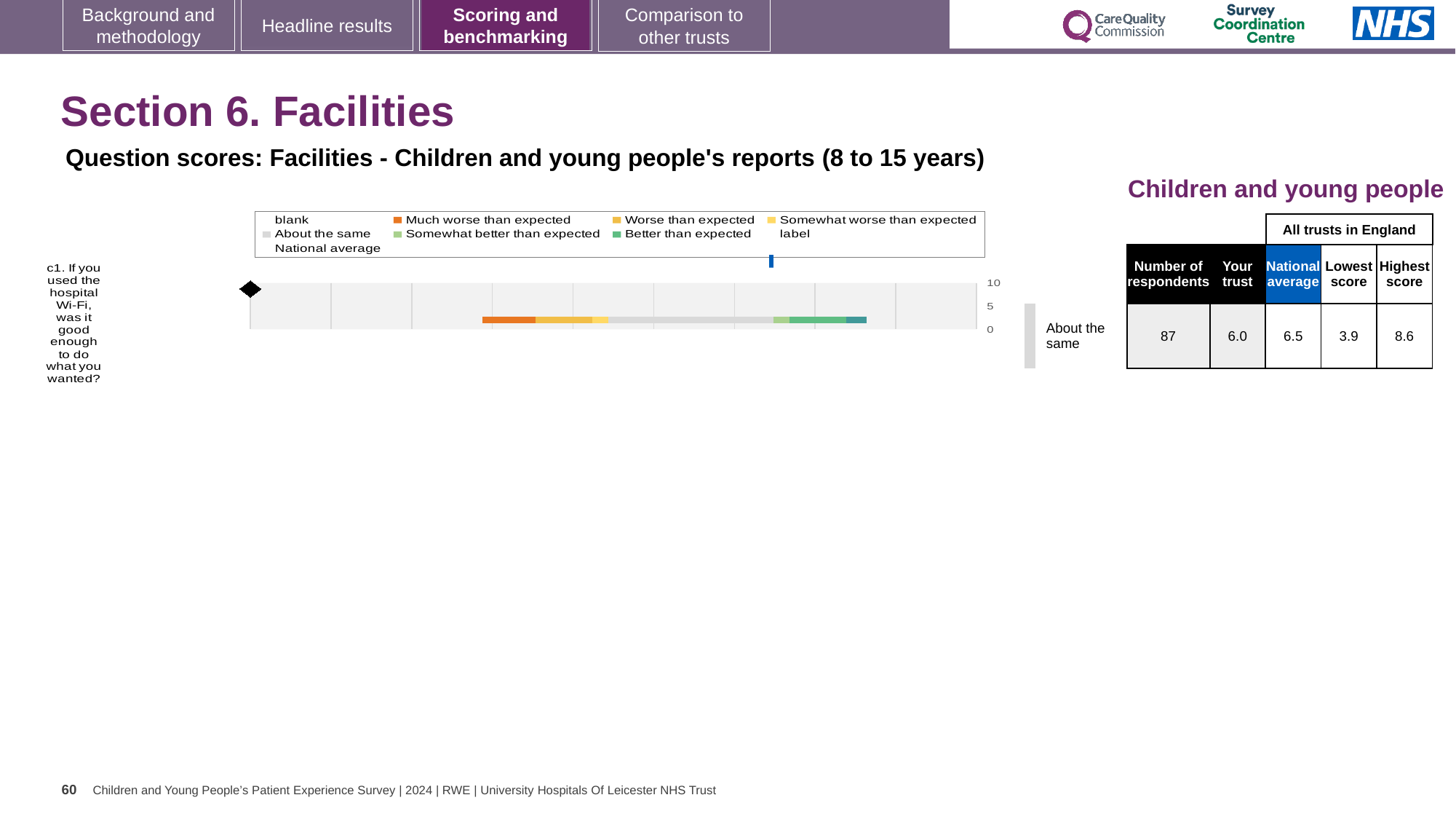
In the table beside the chart, what is the national average score for question c1? 6.5 In the table beside the chart, what is the highest score among all trusts in England for question c1? 8.6 In the table beside the chart, what is the 'Your trust' score for question c1? 6.0 Which is larger for question c1: the 'Your trust' score or the national average? National average Which survey question is plotted in the chart? c1. If you used the hospital Wi-Fi, was it good enough to do what you wanted? How many entries does the chart legend list? 9 What is the difference between the highest score and the lowest score for question c1 in the table? 4.7 In the table beside the chart, what is the lowest score among all trusts in England for question c1? 3.9 What rating label is shown next to the bar for question c1? About the same In the table beside the chart, how many respondents answered question c1? 87 What kind of chart is shown on the slide? bar chart How many survey questions (categories) are plotted in the chart? 1